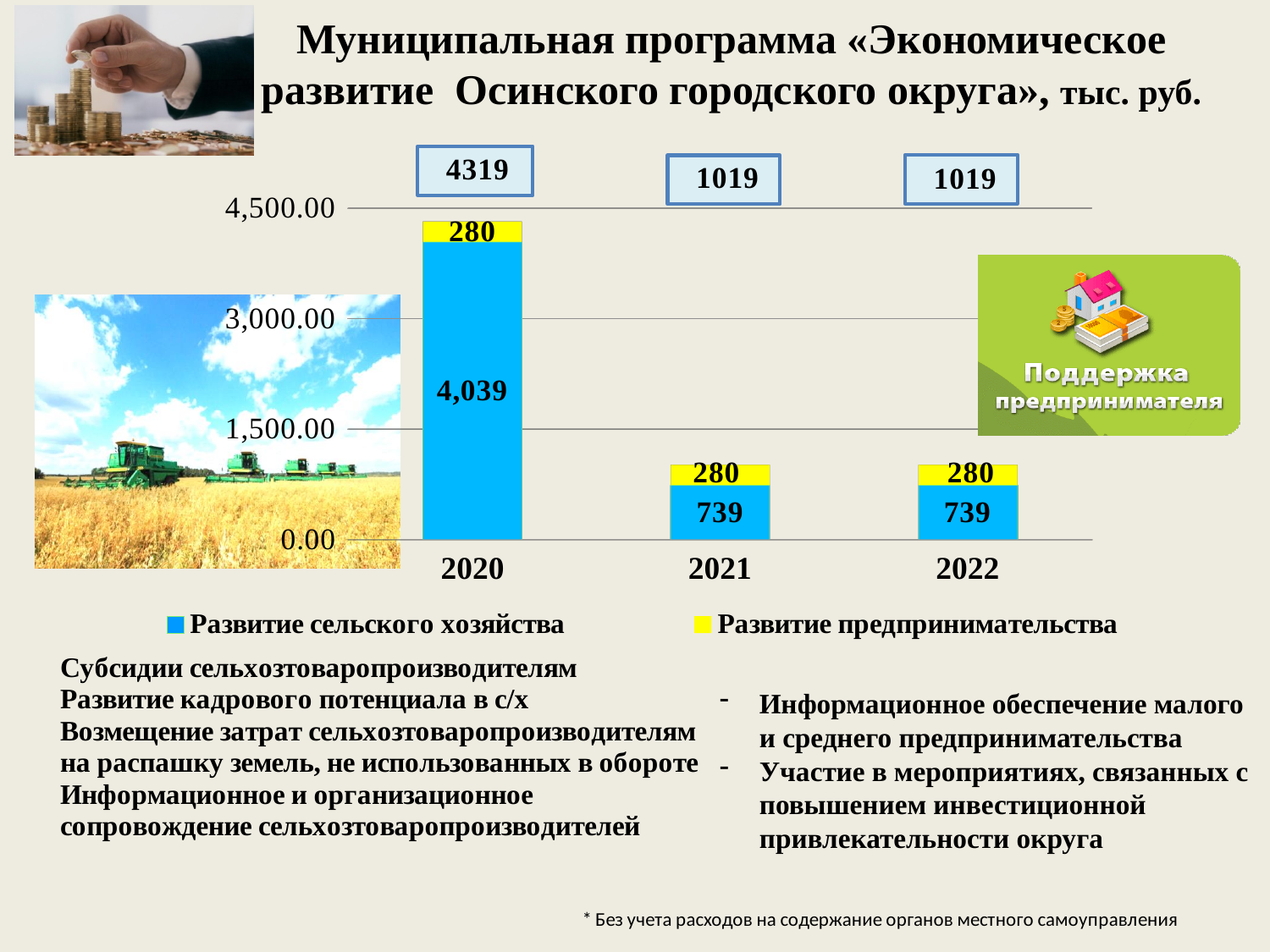
What is the difference between the «Развитие сельского хозяйства» values for 2020 and 2021? 3,300 What is the total shown above the stacked bar for 2020? 4319 What is the value for «Развитие сельского хозяйства» in 2020? 4,039 What type of chart is shown on the slide? bar chart Which year has the highest value for «Развитие сельского хозяйства»? 2020 Which colour represents «Развитие предпринимательства» in the chart? yellow What is the value for «Развитие сельского хозяйства» in 2022? 739 Which is larger: the «Развитие сельского хозяйства» value in 2021 or the «Развитие предпринимательства» value in 2021? Развитие сельского хозяйства What is the total shown above the stacked bar for 2021? 1019 How many years are shown on the x axis of the chart? 3 What is the value for «Развитие предпринимательства» in 2021? 280 How many series does the chart legend list? 2